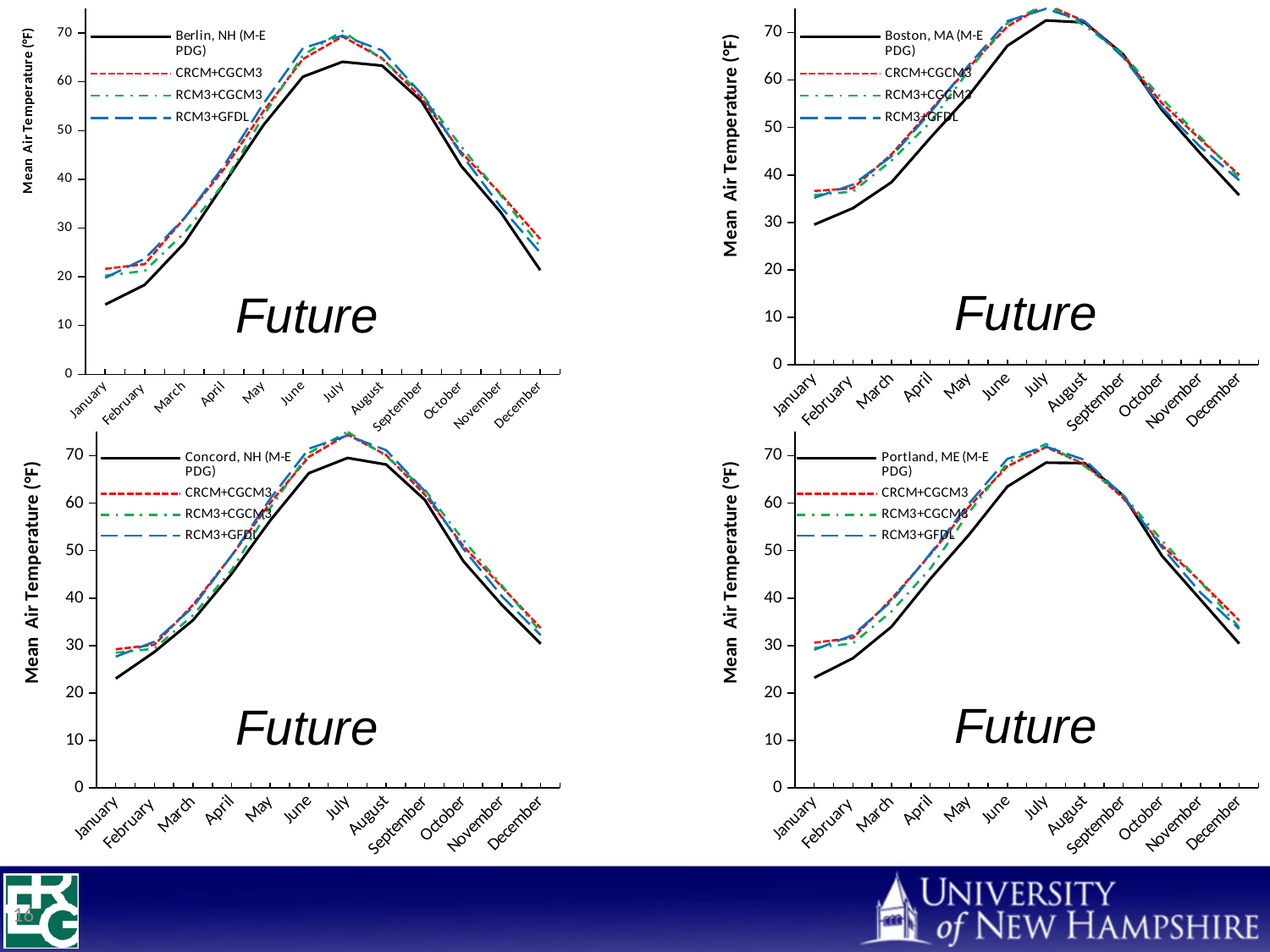
How many months are plotted along the x axis of the bottom-left chart (Concord, NH)? 12 In the top-left chart (Berlin, NH), which month has the highest value for the Berlin, NH (M-E PDG) series? July How many series does the legend of the top-right chart (Boston, MA) list? 4 In the bottom-left chart (Concord, NH), is the January value for Concord, NH (M-E PDG) greater or less than 30? less In the bottom-right chart (Portland, ME), is the July value for Portland, ME (M-E PDG) greater or less than 60? greater In the bottom-left chart (Concord, NH), do the values rise or fall from January to July? rise What kind of chart is the top-left chart (Berlin, NH)? line chart In the bottom-right chart (Portland, ME), which month has the lowest value for the Portland, ME (M-E PDG) series? January In the top-left chart (Berlin, NH), which is higher in January: the Berlin, NH (M-E PDG) series or the CRCM+CGCM3 series? CRCM+CGCM3 In the top-left chart (Berlin, NH), is the January value for Berlin, NH (M-E PDG) greater or less than 20? less What is the y-axis label of the top-right chart (Boston, MA)? Mean Air Temperature (°F)